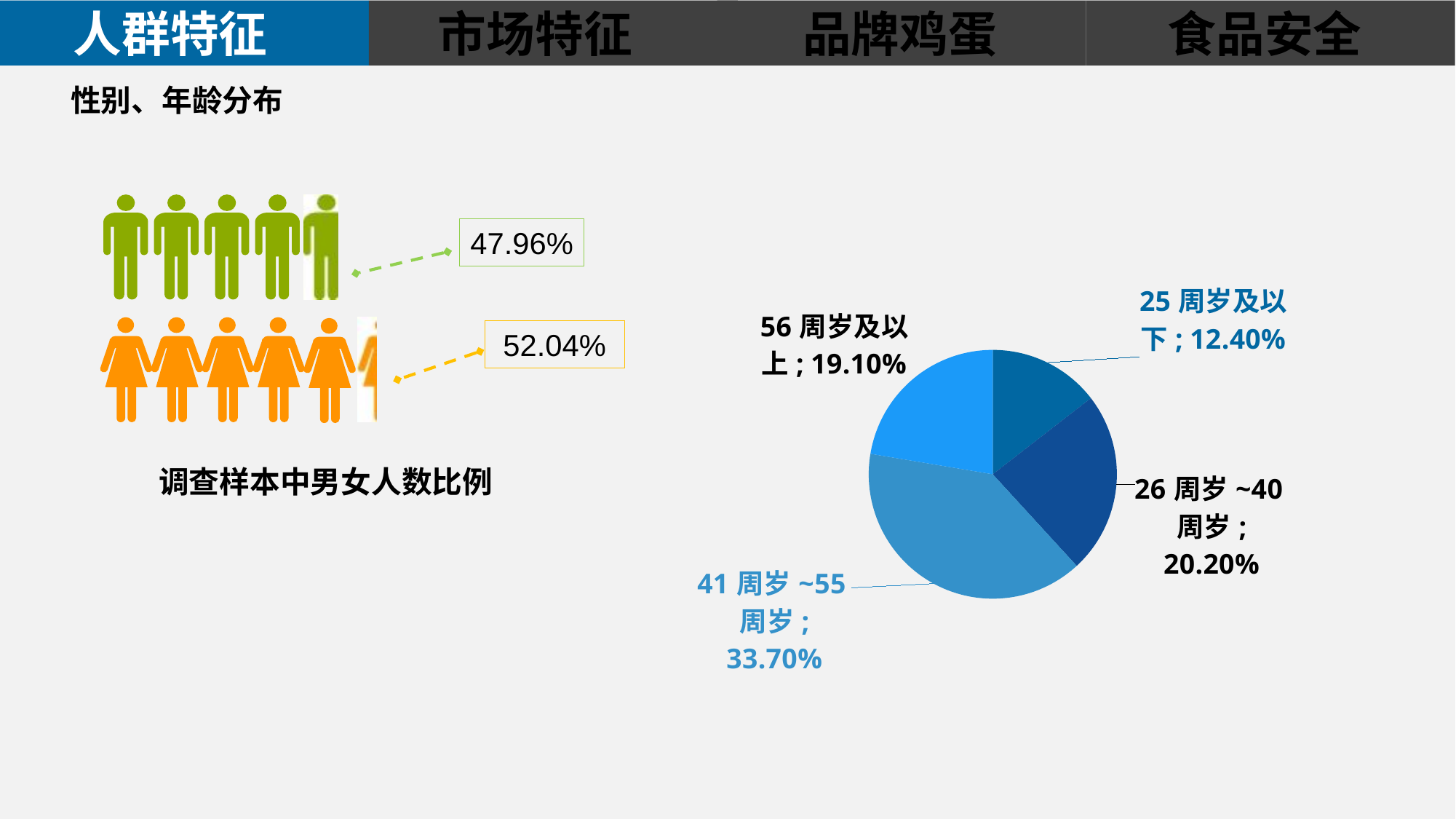
In the age distribution pie chart, how many age groups (slices) are shown? 4 In the age distribution pie chart, what share is shown for 41 周岁 ~55 周岁? 33.70% In the age distribution pie chart, what share is shown for 26 周岁 ~40 周岁? 20.20% In the gender ratio graphic on the left of the slide, what percentage is shown for the female figures? 52.04% In the age distribution pie chart, what share is shown for 56 周岁及以上? 19.10% In the age distribution pie chart, which age group has the largest share? 41 周岁 ~55 周岁 What kind of chart is the age distribution chart on the right of the slide? pie chart In the gender ratio graphic on the left of the slide, what percentage is shown for the male figures? 47.96% In the age distribution pie chart, what is the difference between the shares of 41 周岁 ~55 周岁 and 26 周岁 ~40 周岁? 13.50% In the age distribution pie chart, which age group has the smallest share? 25 周岁及以下 In the age distribution pie chart, which has a larger share: 56 周岁及以上 or 25 周岁及以下? 56 周岁及以上 In the age distribution pie chart, what share is shown for 25 周岁及以下? 12.40%